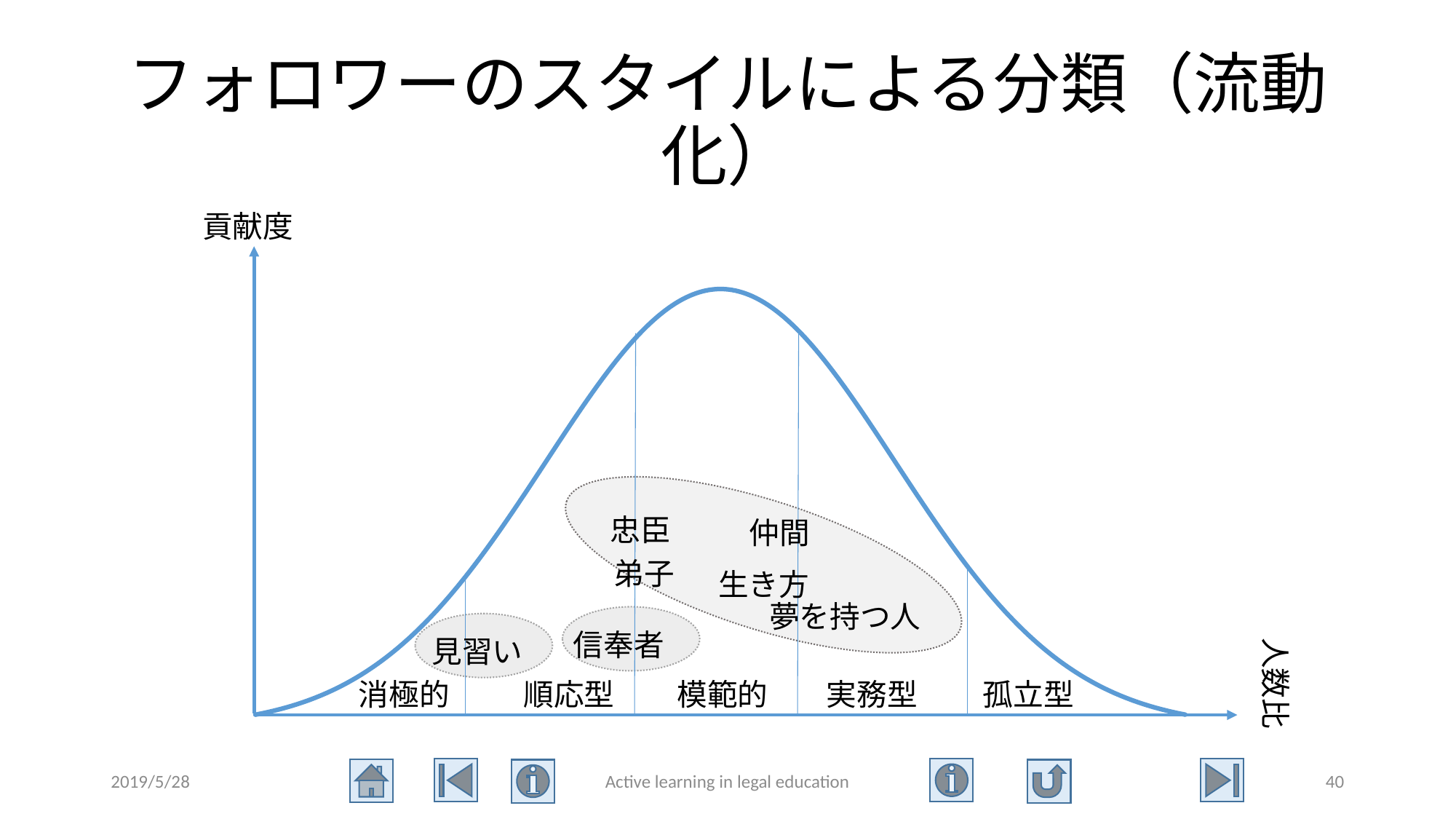
Which category lies between 順応型 and 実務型 on the horizontal axis? 模範的 How many categories are labelled along the horizontal axis of the chart? 5 Which label is inside the small dotted ellipse above 消極的? 見習い What is the title of the chart on this slide? フォロワーのスタイルによる分類（流動化） Under which category label does the curve reach its highest point? 模範的 Which category is labelled at the far right of the horizontal axis? 孤立型 What shape does the plotted curve have? bell curve Which category is labelled at the far left of the horizontal axis? 消極的 What label is on the vertical axis of the chart? 貢献度 Does the curve rise or fall as it moves from 実務型 to 孤立型? fall What label is on the horizontal axis of the chart? 人数比 Does the curve rise or fall as it moves from 消極的 to 模範的? rise